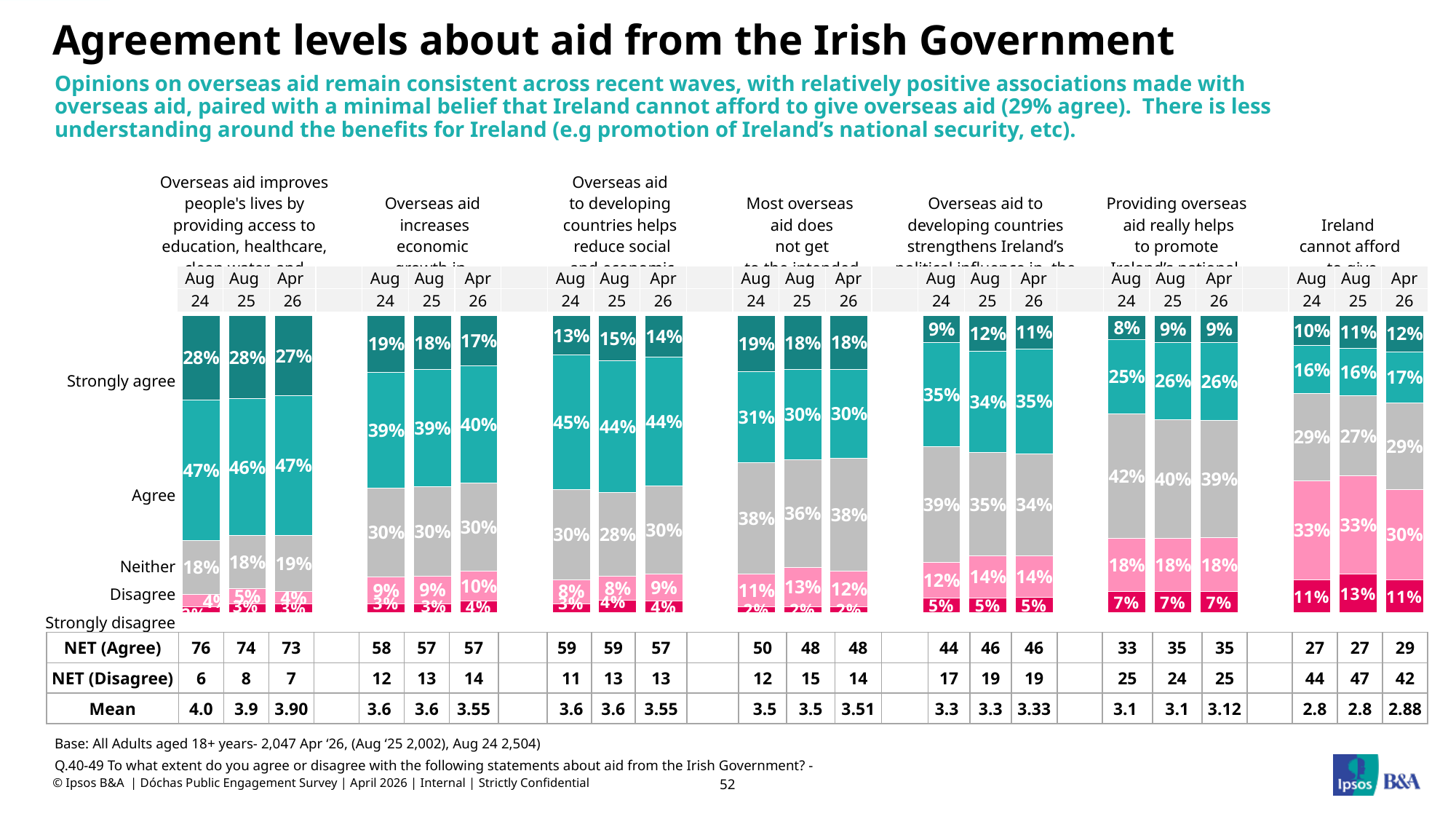
What kind of chart is used to show the agreement levels on this slide? Stacked bar chart Which statement has the highest NET (Agree) value in Apr 26? Overseas aid improves people's lives by providing access to education, healthcare... In the leftmost chart ('Overseas aid improves people's lives...'), by how much did NET (Agree) fall from Aug 24 to Apr 26? 3 In the chart for the statement 'Ireland cannot afford to give...', what percentage strongly disagreed in Aug 25? 13% Which statement has the lowest Mean score in Apr 26? Ireland cannot afford to give... In the leftmost chart ('Overseas aid improves people's lives...'), what percentage agreed in Apr 26? 47% In the chart for 'Overseas aid increases economic growth...', does NET (Disagree) rise or fall from Aug 24 to Apr 26? Rise How many survey waves are shown for each statement? 3 How many response categories are listed down the left side of the charts? 5 In the chart for 'Ireland cannot afford to give...', what is the NET (Agree) value for Apr 26? 29 For Aug 24, which has the larger 'Strongly agree' share: 'Providing overseas aid really helps to promote...' or 'Ireland cannot afford to give...'? Ireland cannot afford to give... What is the Mean score for 'Most overseas aid does not get to the intended...' in Apr 26? 3.51